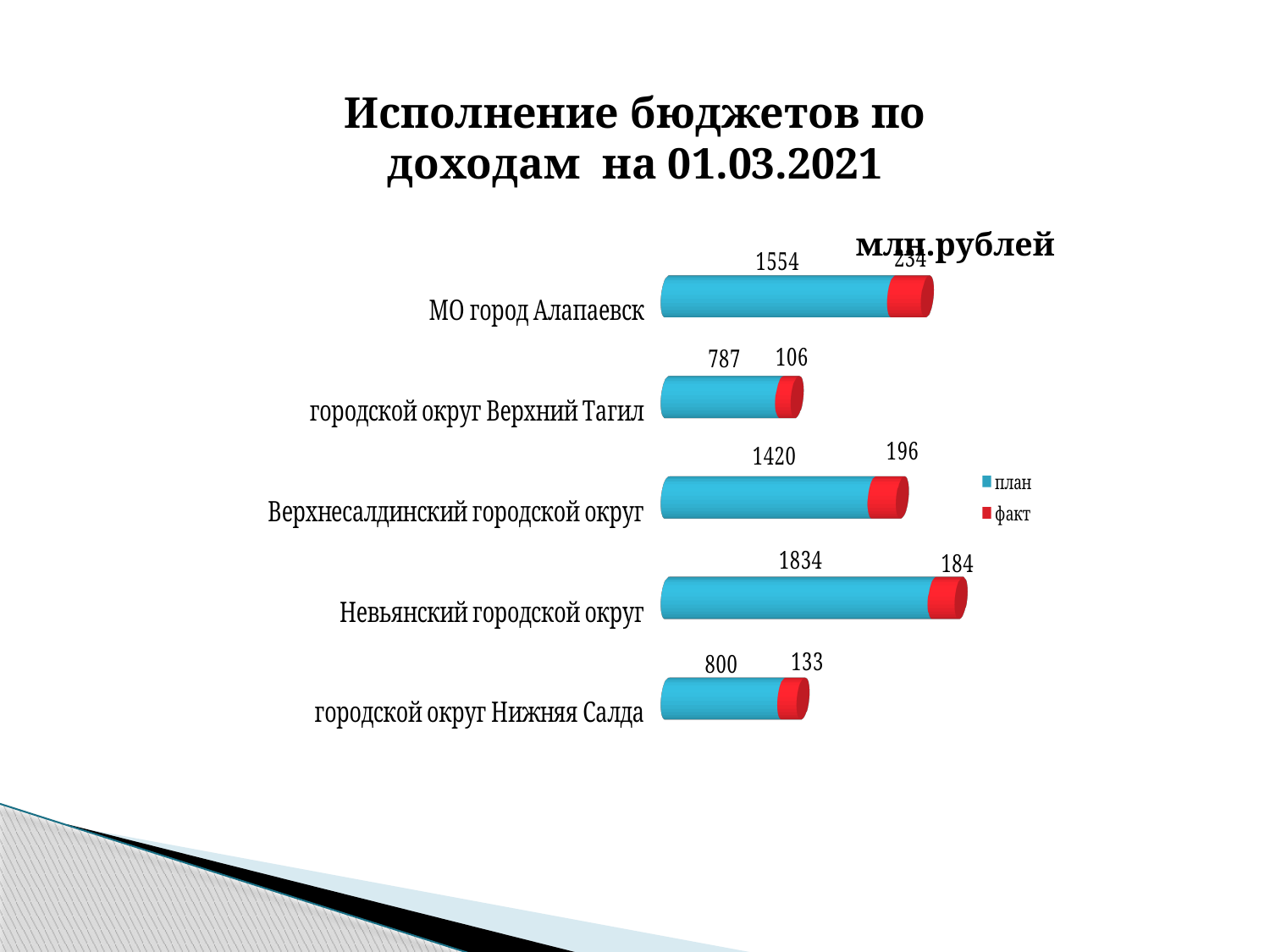
What is the план value for Невьянский городской округ? 1834 What kind of chart is shown on the slide? Bar chart What is the план value for городской округ Верхний Тагил? 787 Which category has the lowest план value? городской округ Верхний Тагил How many categories are shown in the chart? 5 Which has the larger план value: Верхнесалдинский городской округ or МО город Алапаевск? МО город Алапаевск What is the факт value for Верхнесалдинский городской округ? 196 Which category has the lowest факт value? городской округ Верхний Тагил Which category has the highest план value? Невьянский городской округ How many series does the legend list? 2 What is the difference between the план and факт values for Невьянский городской округ? 1650 What is the факт value for городской округ Нижняя Салда? 133